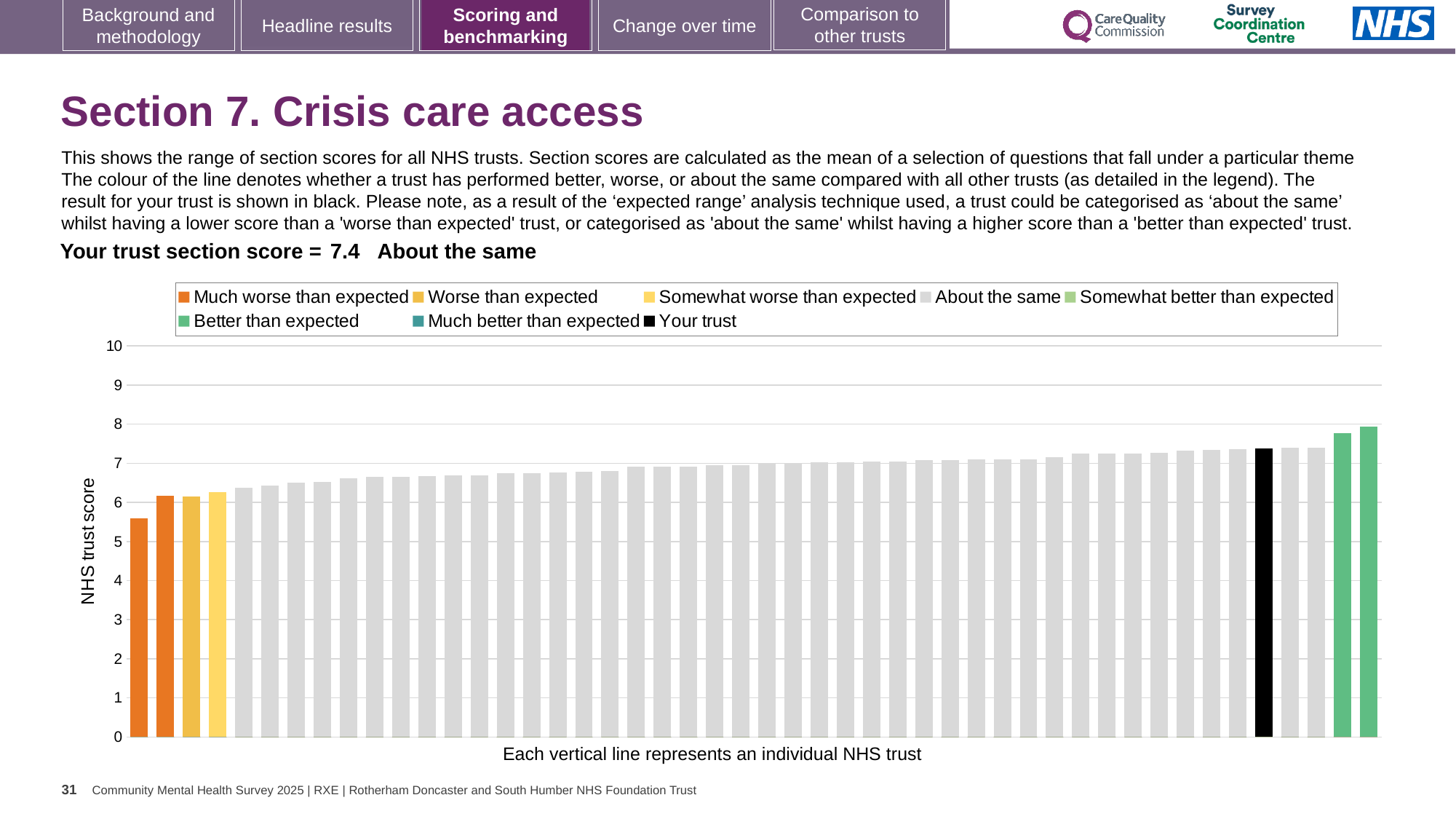
Is the value of the tallest bar in the chart greater or less than 7? greater Which legend category does the shortest bar in the chart belong to? Much worse than expected Which performance category is your trust placed in for crisis care access? About the same What is the section score for your trust shown on the slide? 7.4 How many bars are coloured orange (Much worse than expected)? 2 Do the bar values rise or fall moving from left to right along the x axis? rise Is the value of the shortest bar in the chart greater or less than 6? less How many entries does the chart legend list? 8 Which legend category does the tallest bar in the chart belong to? Better than expected What is the label on the vertical axis of the chart? NHS trust score What kind of chart is shown on the slide? bar chart Is the value of the black bar (your trust) greater or less than 7? greater